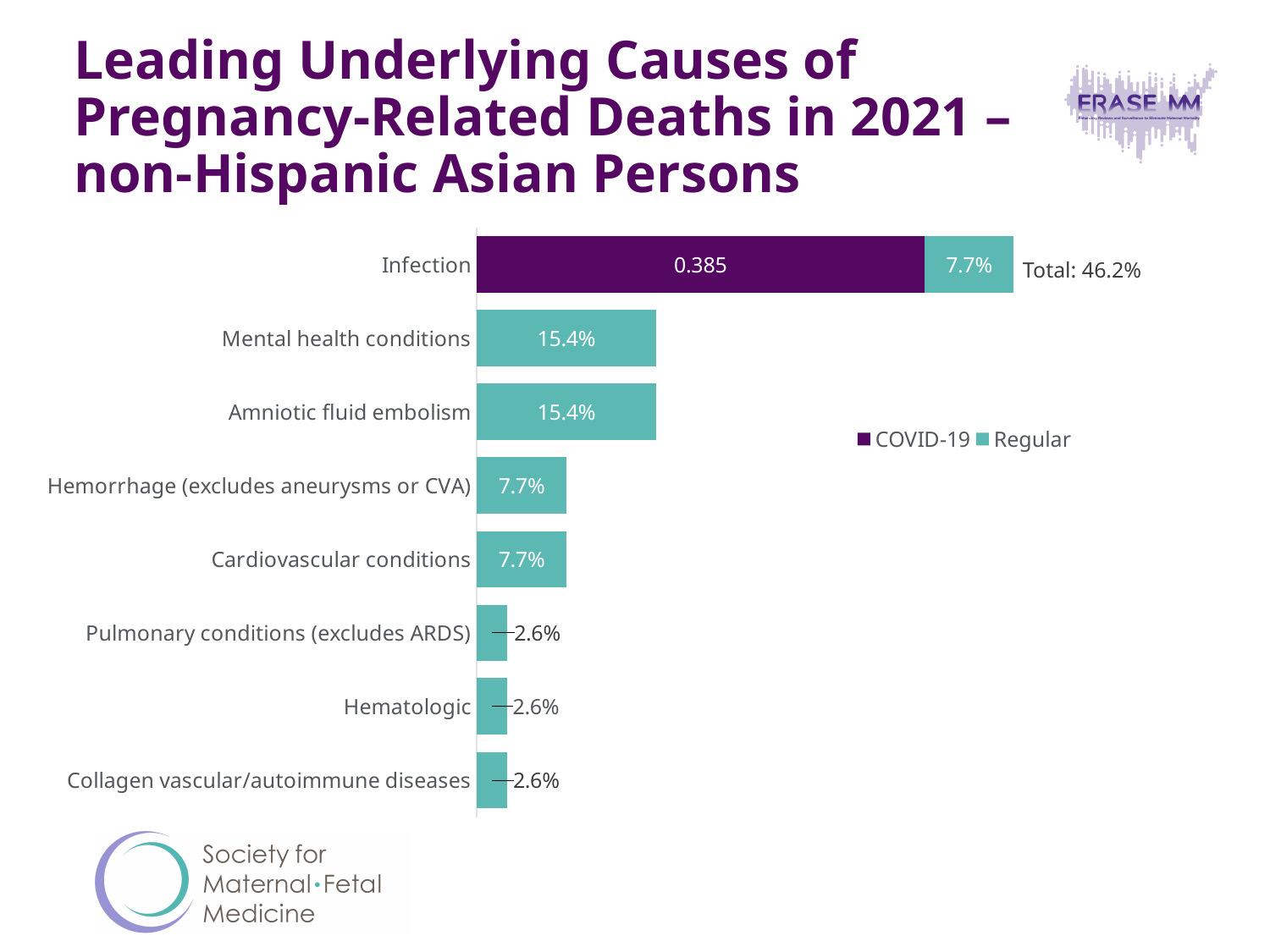
Which is larger, the value for Mental health conditions or the value for Pulmonary conditions (excludes ARDS)? Mental health conditions What is the value for Hematologic? 2.6% Which category has the longest bar overall? Infection What is the Regular value for Infection? 7.7% What total is printed next to the Infection bar? Total: 46.2% What is the COVID-19 value shown for Infection? 0.385 What is the difference between the values for Amniotic fluid embolism and Cardiovascular conditions? 7.7% What is the Regular value for Mental health conditions? 15.4% How many series does the legend list? 2 What is the value for Hemorrhage (excludes aneurysms or CVA)? 7.7% What kind of chart is shown on the slide? Stacked bar chart How many categories are shown on the chart? 8